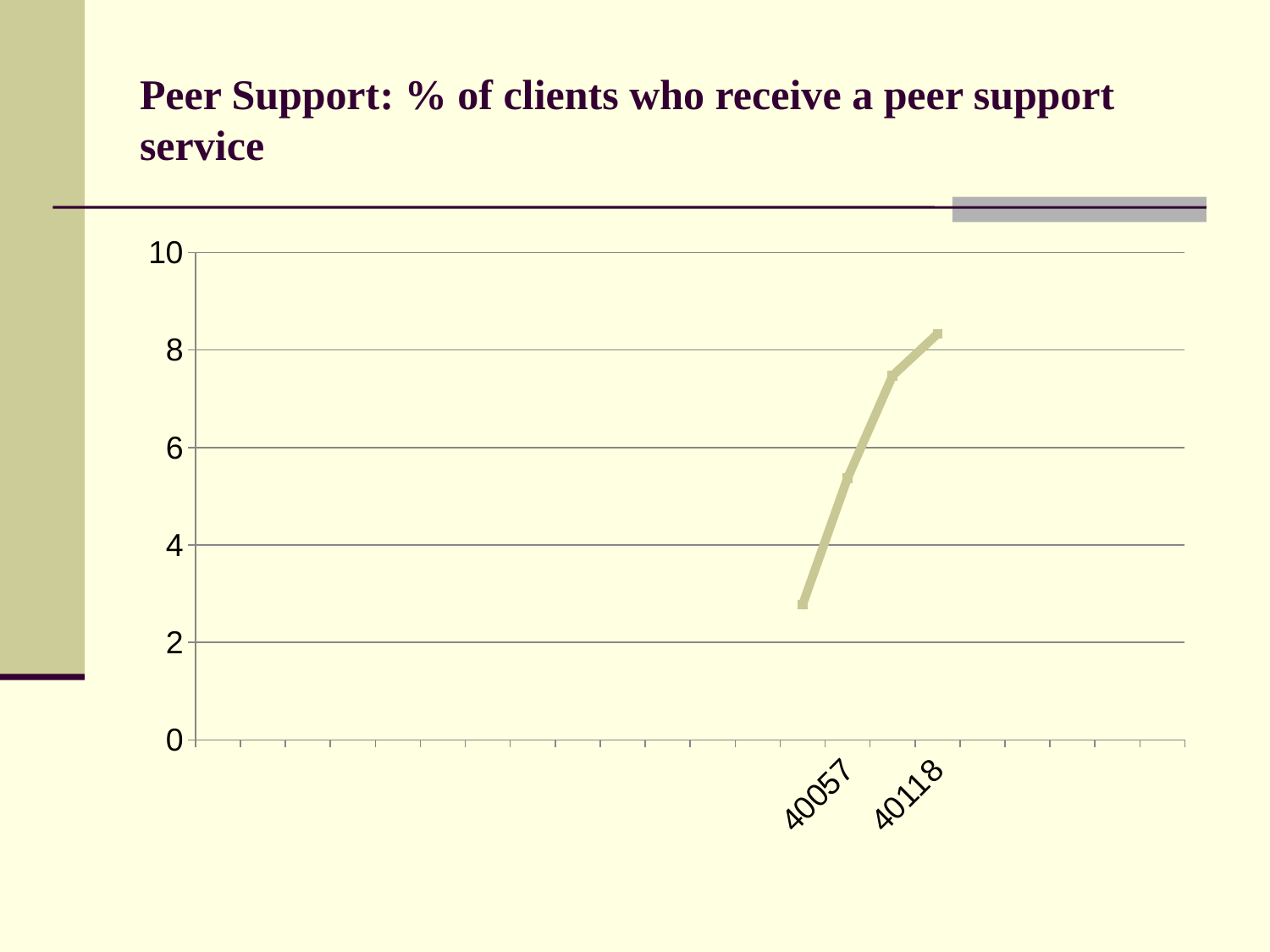
Which plotted point has the lowest value, the first or the last? the first What is the maximum value shown on the y axis? 10 Is the highest plotted value greater or less than 8? greater How many data points are plotted on the line? 4 What kind of chart is shown on the slide? line chart Is the value at 40118 greater or less than 6? greater Which plotted point has the highest value, the first or the last? the last Do the values rise or fall from left to right along the x axis? rise Is the lowest plotted value greater or less than 4? less What is the title of the slide containing the chart? Peer Support: % of clients who receive a peer support service Which is larger, the value at 40057 or the value at 40118? 40118